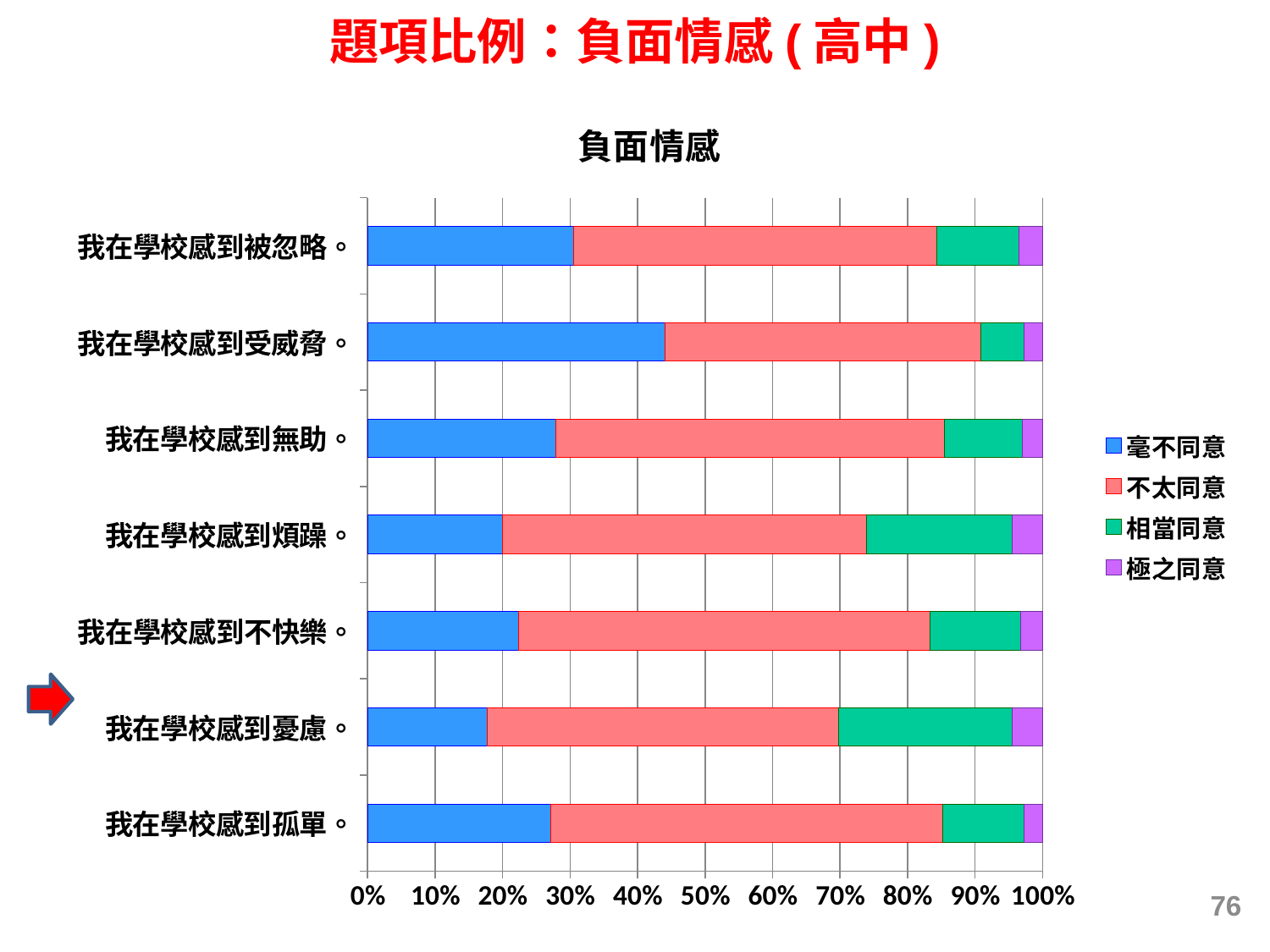
Is the 毫不同意 share for 我在學校感到憂慮。 greater or less than 20%? less Is the 毫不同意 share for 我在學校感到受威脅。 greater or less than 40%? greater What does each stacked bar total on the x axis? 100% Which has a larger 毫不同意 segment: 我在學校感到受威脅。 or 我在學校感到無助。? 我在學校感到受威脅。 What is the title of the chart? 負面情感 What kind of chart is shown on the slide? Stacked bar chart Which statement has the largest 相當同意 segment? 我在學校感到憂慮。 Is the 毫不同意 share for 我在學校感到無助。 greater or less than 30%? less Which statement has the largest 毫不同意 segment? 我在學校感到受威脅。 How many statements (categories) are plotted on the chart? 7 Which colour represents 極之同意 in the chart? Purple How many series does the legend list? 4